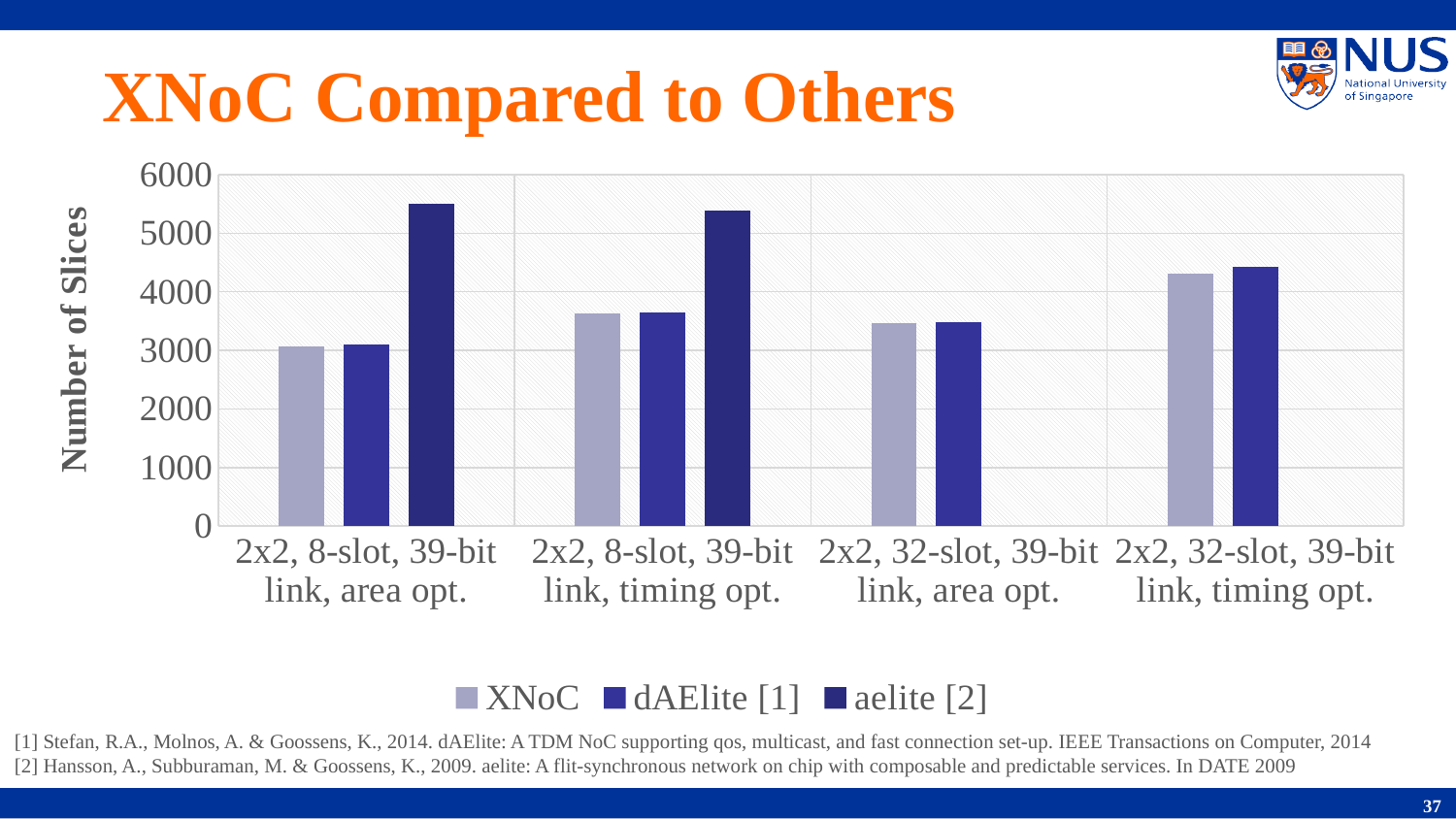
Is the XNoC value for "2x2, 32-slot, 39-bit link, timing opt." greater or less than 4000? greater What kind of chart is shown on the slide? bar chart Which series has the highest value for the "2x2, 8-slot, 39-bit link, timing opt." configuration? aelite [2] For how many of the configurations is an aelite [2] bar plotted? 2 How many configuration categories are shown along the x axis? 4 How many series does the legend list? 3 Is the XNoC value for "2x2, 8-slot, 39-bit link, area opt." greater or less than 4000? less Is the dAElite [1] value for "2x2, 32-slot, 39-bit link, area opt." greater or less than 4000? less For "2x2, 8-slot, 39-bit link, timing opt.", which is larger: the XNoC value or the aelite [2] value? aelite [2] Which series has the highest value for the "2x2, 8-slot, 39-bit link, area opt." configuration? aelite [2] What is the label of the vertical axis? Number of Slices